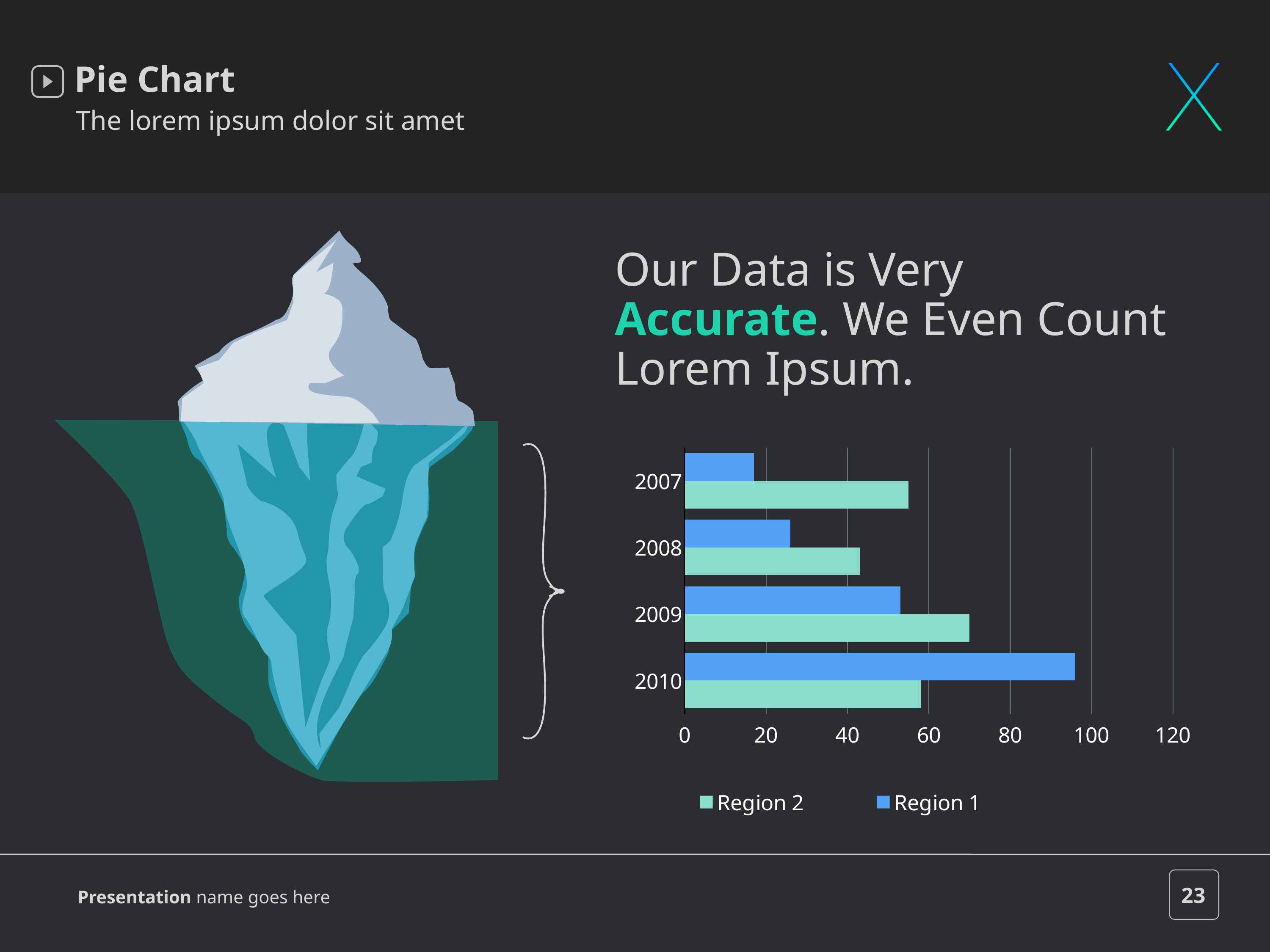
Do the values for Region 1 rise or fall from 2007 to 2010? rise In which year is the value for Region 1 the highest? 2010 Is the value for Region 1 in 2007 greater or less than 20? less Is the value for Region 2 in 2009 greater or less than 60? greater Is the value for Region 2 in 2007 greater or less than 40? greater In 2010, which series has the larger value, Region 1 or Region 2? Region 1 How many series does the chart legend list? 2 In which year is the value for Region 2 the highest? 2009 What kind of chart is shown on the slide? bar chart In which year is the value for Region 1 the lowest? 2007 How many years are shown on the chart's category axis? 4